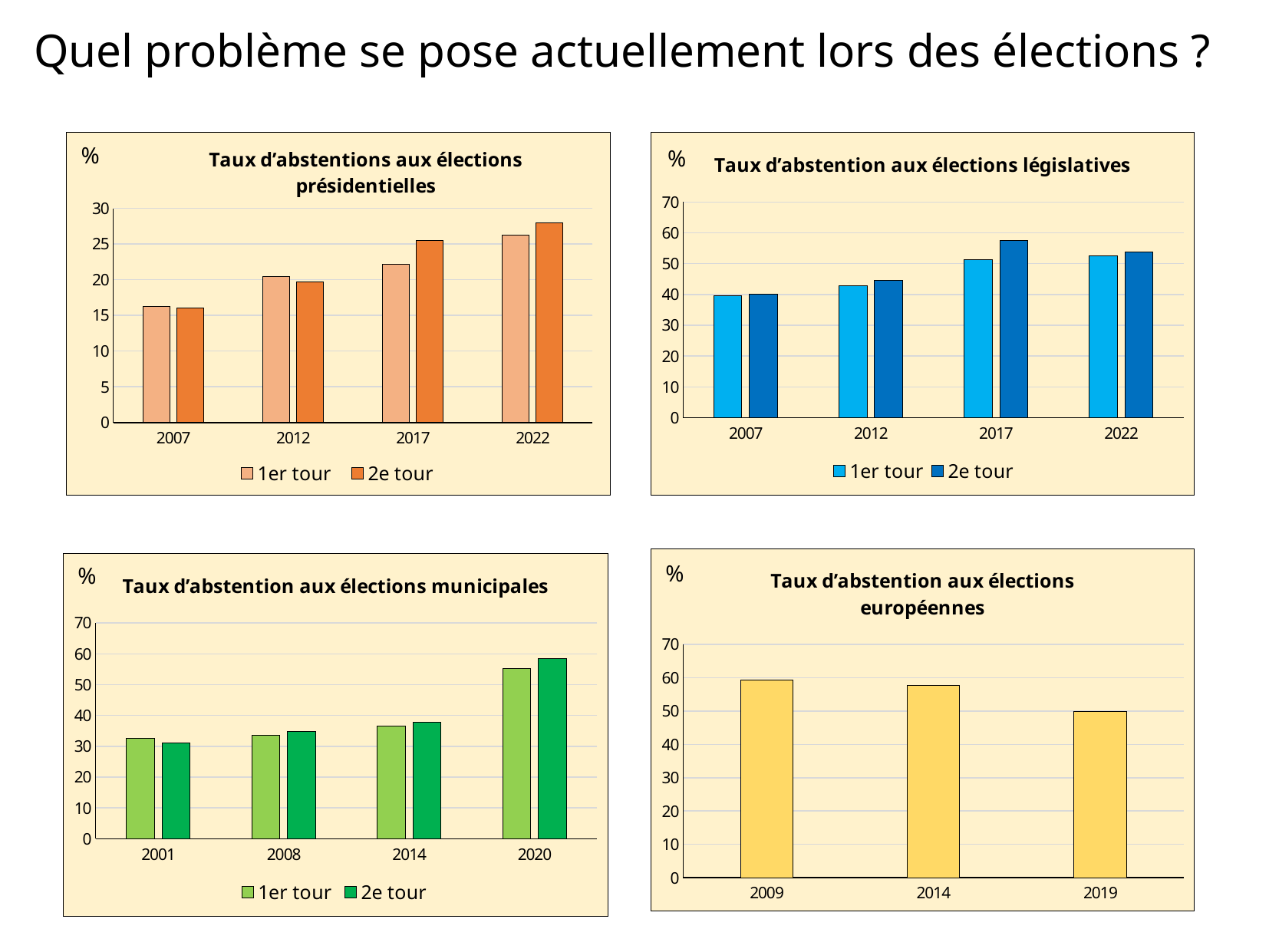
In the chart 'Taux d'abstention aux élections européennes', do the values rise or fall from 2009 to 2019? fall In the chart 'Taux d'abstention aux élections législatives', how many series does the legend list? 2 In the chart 'Taux d'abstentions aux élections présidentielles', is the value for the 1er tour in 2022 greater or less than 25? greater In the chart 'Taux d'abstentions aux élections présidentielles', do the 1er tour values rise or fall from 2007 to 2022? rise What kind of chart is 'Taux d'abstention aux élections européennes'? bar chart In the chart 'Taux d'abstention aux élections municipales', which year and round has the highest abstention rate? 2020, 2e tour In the chart 'Taux d'abstention aux élections municipales', is the value for the 1er tour in 2020 greater or less than 50? greater In the chart 'Taux d'abstentions aux élections présidentielles', which year and round has the highest abstention rate? 2022, 2e tour In the chart 'Taux d'abstention aux élections européennes', which year has the lowest abstention rate? 2019 In the chart 'Taux d'abstention aux élections législatives', which year and round has the highest abstention rate? 2017, 2e tour In the chart 'Taux d'abstention aux élections municipales', how many years are shown on the x axis? 4 In the chart 'Taux d'abstention aux élections législatives', is the value for the 1er tour in 2012 greater or less than 50? less